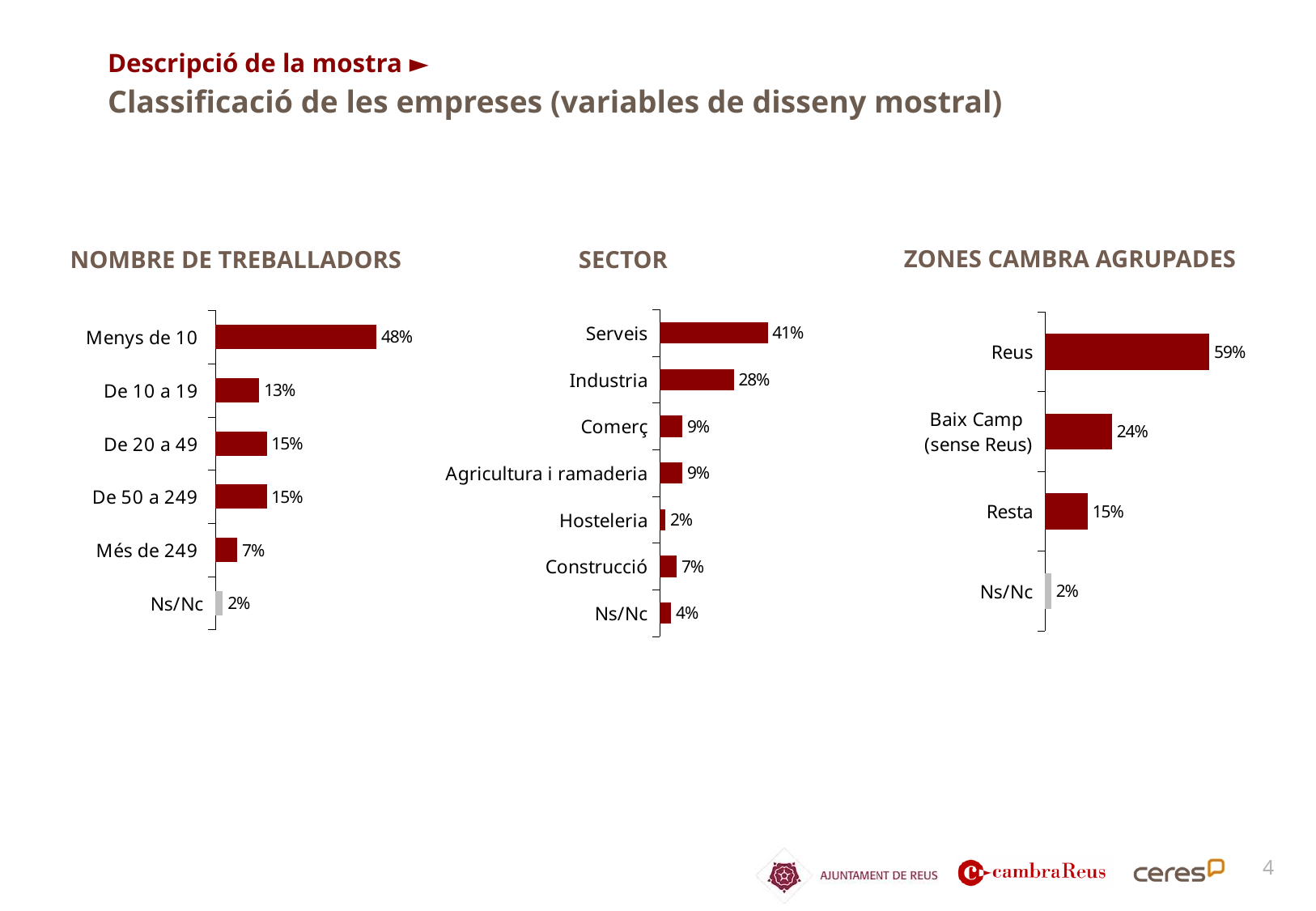
In the SECTOR chart, how many categories are shown? 7 In the SECTOR chart, which category has the highest value? Serveis In the SECTOR chart, what is the value for Industria? 28% In the ZONES CAMBRA AGRUPADES chart, which bar is coloured grey rather than dark red? Ns/Nc In the NOMBRE DE TREBALLADORS chart, which category has the lowest value? Ns/Nc In the NOMBRE DE TREBALLADORS chart, what is the difference between Menys de 10 and De 10 a 19? 35% In the SECTOR chart, which is larger, Construcció or Hosteleria? Construcció In the ZONES CAMBRA AGRUPADES chart, what is the difference between Reus and Resta? 44% In the NOMBRE DE TREBALLADORS chart, how many categories are shown? 6 What kind of chart is the ZONES CAMBRA AGRUPADES chart? Bar chart In the ZONES CAMBRA AGRUPADES chart, what is the value for Baix Camp (sense Reus)? 24% In the NOMBRE DE TREBALLADORS chart, what is the value for Menys de 10? 48%